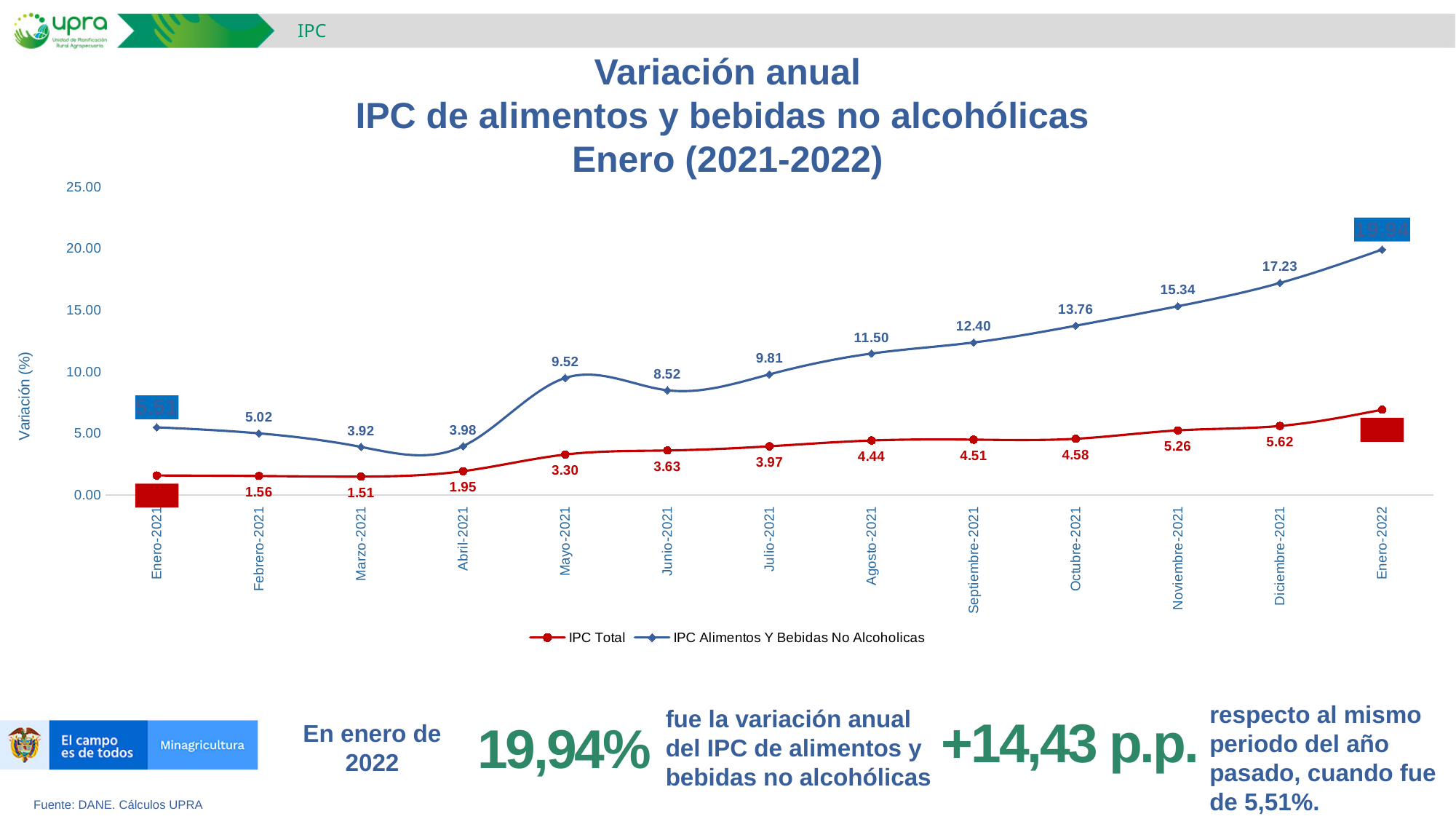
How many series does the legend list? 2 What is the value of IPC Alimentos Y Bebidas No Alcoholicas in Noviembre-2021? 15.34 How many months are shown on the x axis? 13 What is the value of IPC Total in Diciembre-2021? 5.62 Is the value of IPC Total in Enero-2022 greater or less than 5.00? greater By how much did IPC Total increase from Julio-2021 to Agosto-2021? 0.47 What is the difference between IPC Alimentos Y Bebidas No Alcoholicas and IPC Total in Diciembre-2021? 11.61 What kind of chart is shown on the slide? line chart In which month does IPC Alimentos Y Bebidas No Alcoholicas reach its highest value? Enero-2022 In which month does IPC Alimentos Y Bebidas No Alcoholicas have its lowest value? Marzo-2021 What is the value of IPC Alimentos Y Bebidas No Alcoholicas in Mayo-2021? 9.52 Which is higher for IPC Alimentos Y Bebidas No Alcoholicas: Mayo-2021 or Junio-2021? Mayo-2021